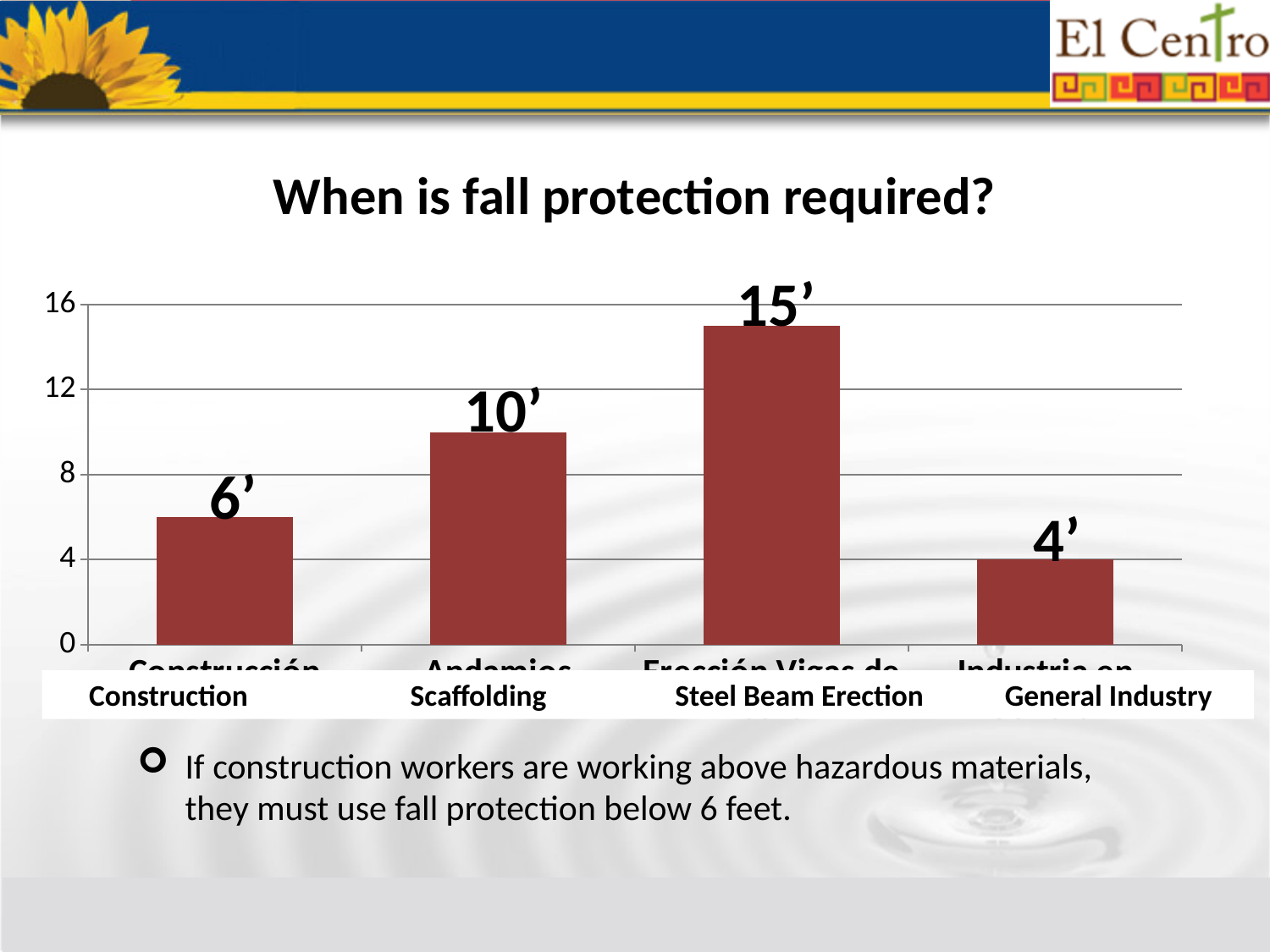
What is the value shown for General Industry? 4' What is the value shown for Construction? 6' What is the title of the slide above the chart? When is fall protection required? Which category has the highest value? Steel Beam Erection How many categories are shown in the chart? 4 What is the value shown for Steel Beam Erection? 15' Which category has the lowest value? General Industry What kind of chart is shown on the slide? bar chart What is the difference between the values for Steel Beam Erection and Scaffolding? 5' Is the value for Scaffolding greater or less than 8? greater What is the value shown for Scaffolding? 10' Which is larger, the value for Construction or the value for General Industry? Construction